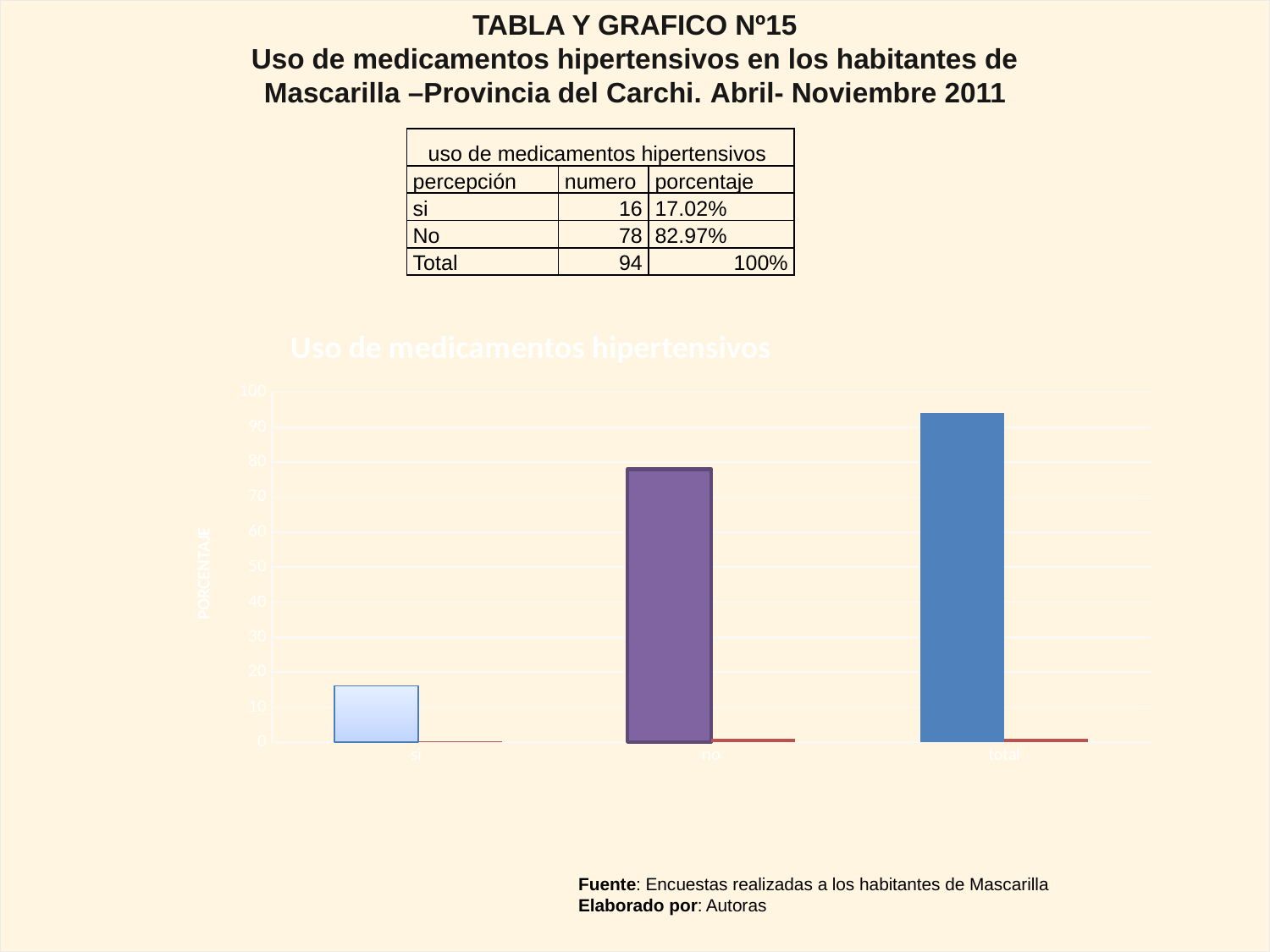
What kind of chart is shown on the slide? bar chart Is the value for 'total' in the chart greater or less than 90? greater Which category has the shortest bar in the chart? si What is the label on the vertical axis of the chart? PORCENTAJE Which category has the tallest bar in the chart? total Do the bar values rise or fall from left to right along the x axis? rise How many categories are plotted on the x axis of the chart? 3 Is the value for 'no' in the chart greater or less than 70? greater Which bar is taller in the chart, 'si' or 'no'? no Is the value for 'si' in the chart greater or less than 20? less What is the title of the chart? Uso de medicamentos hipertensivos